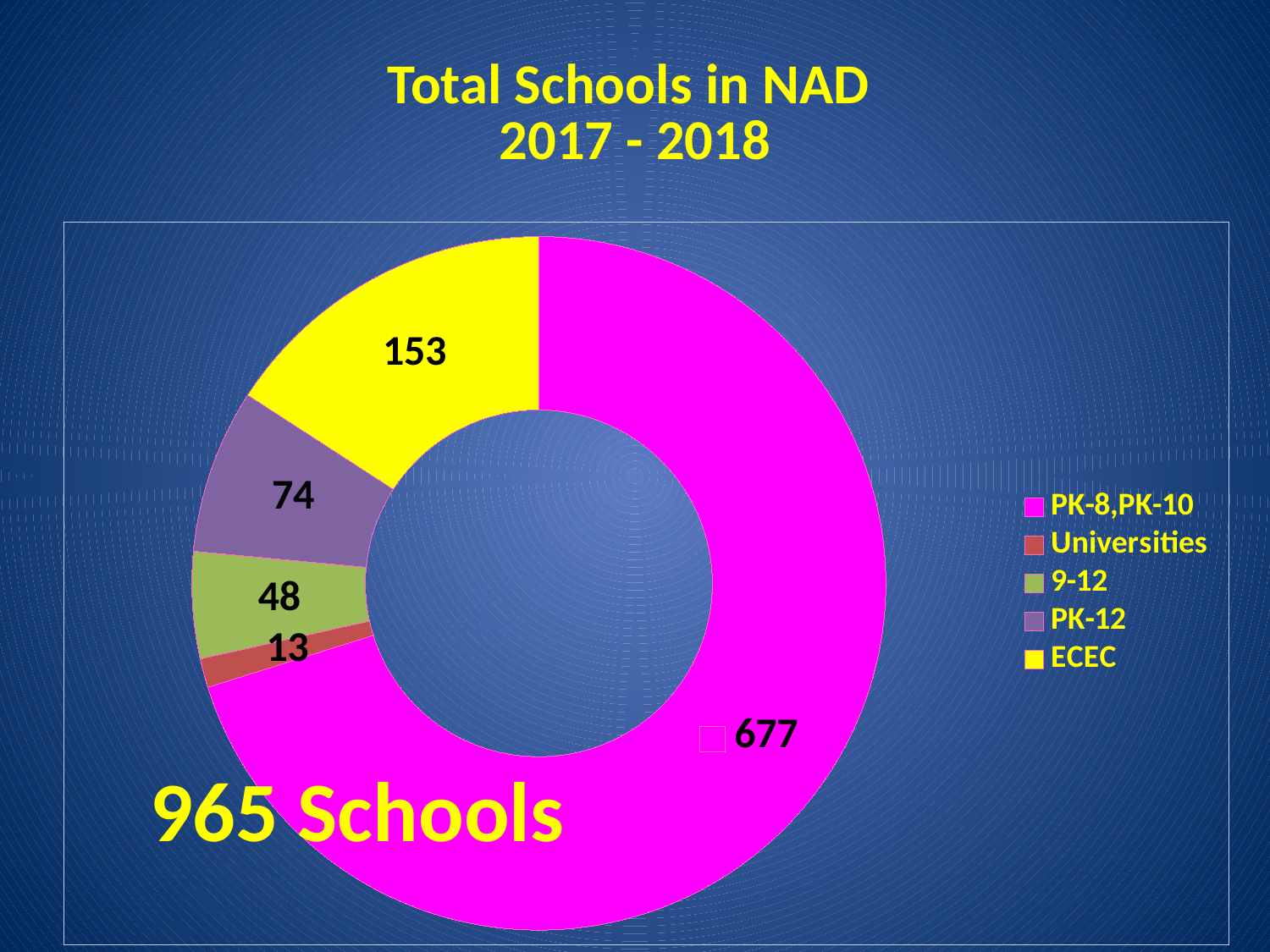
What is the value for Universities? 13 Which is larger, the value for 9-12 or the value for PK-12? PK-12 How many categories does the chart show? 5 Which category has the smallest value? Universities What is the value for PK-12? 74 What is the title of the chart? Total Schools in NAD 2017 - 2018 What kind of chart is shown on the slide? doughnut chart What is the total number of schools shown on the slide? 965 Schools Which category has the largest value? PK-8,PK-10 What is the value for PK-8,PK-10? 677 What is the difference between the values for ECEC and PK-12? 79 What is the value for ECEC? 153